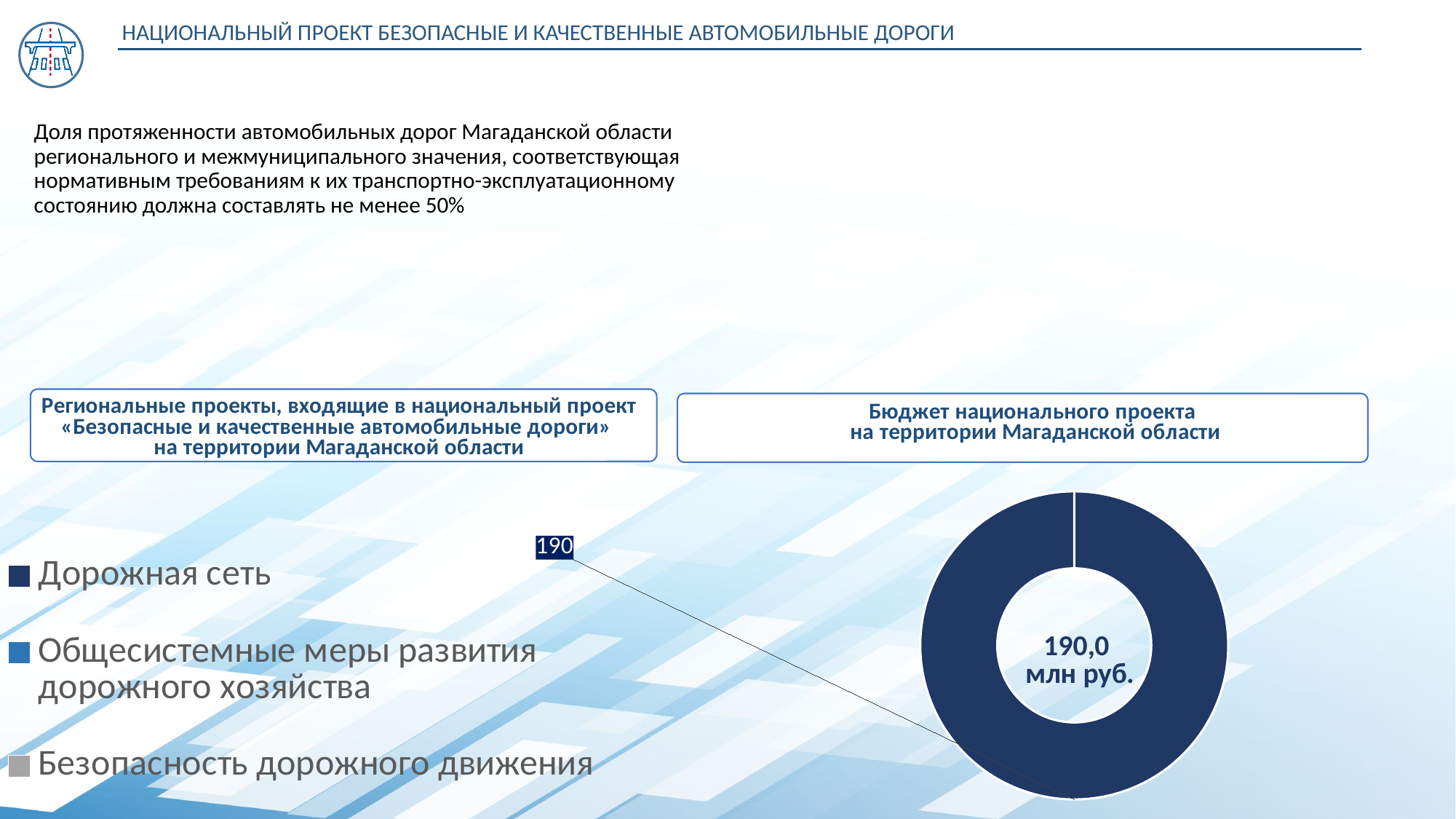
What kind of chart is shown on the slide? Donut (pie) chart Which legend entry corresponds to the dark blue colour in the chart? Дорожная сеть How many entries does the legend of the chart list? 3 Which category accounts for the largest share of the donut chart? Дорожная сеть How many slices are visibly plotted in the donut chart? 1 What value is shown by the data label for the "Дорожная сеть" slice? 190 What text is shown in the centre of the donut chart? 190,0 млн руб. Is the value for "Дорожная сеть" greater or less than 100? greater